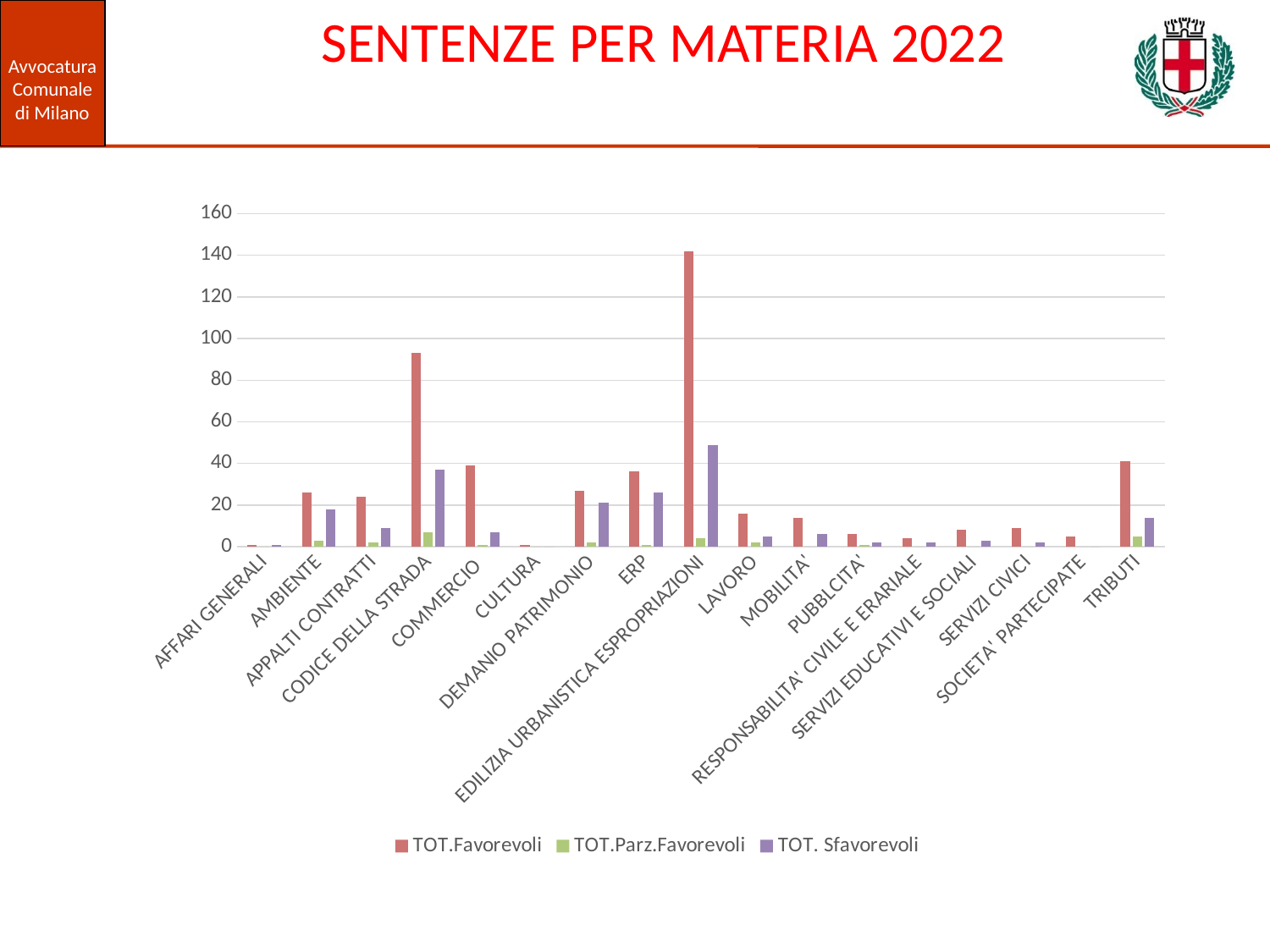
Which category has the highest TOT.Favorevoli value? EDILIZIA URBANISTICA ESPROPRIAZIONI Which has the larger TOT.Favorevoli value, CODICE DELLA STRADA or COMMERCIO? CODICE DELLA STRADA What kind of chart is shown on the slide? bar chart Is the TOT.Favorevoli value for EDILIZIA URBANISTICA ESPROPRIAZIONI greater or less than 120? greater Is the TOT.Favorevoli value for CODICE DELLA STRADA greater or less than 80? greater How many categories are shown on the x axis? 17 Is the TOT. Sfavorevoli value for CODICE DELLA STRADA greater or less than 20? greater Which category has the highest TOT. Sfavorevoli value? EDILIZIA URBANISTICA ESPROPRIAZIONI How many series does the legend list? 3 What is the title of the chart? SENTENZE PER MATERIA 2022 For ERP, which is larger, TOT.Favorevoli or TOT. Sfavorevoli? TOT.Favorevoli